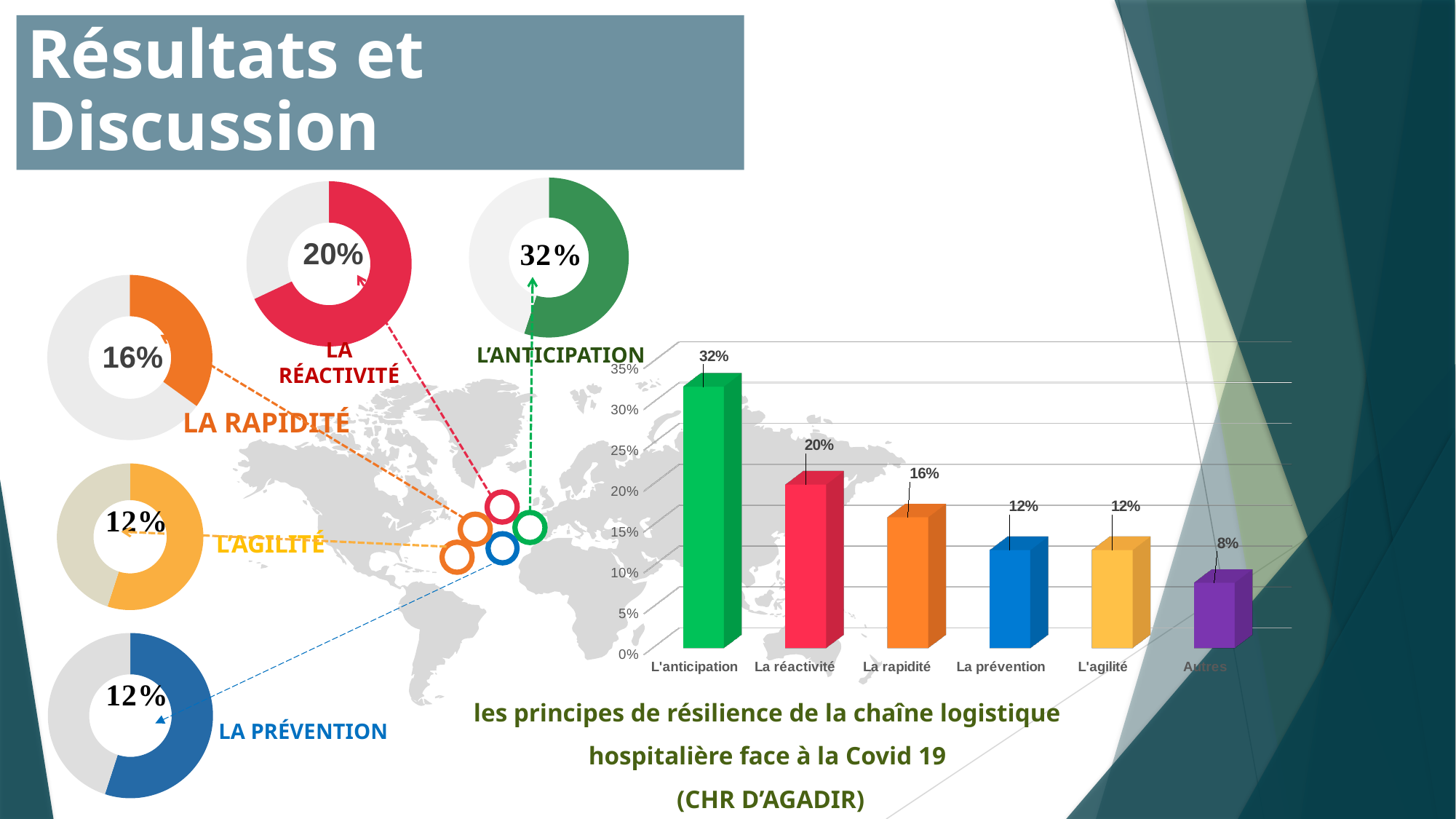
In the bar chart, what is the difference between the values for L'anticipation and La réactivité? 12% In the bar chart, which category has the lowest value? Autres In the bar chart, which is larger, the value for La rapidité or the value for La prévention? La rapidité In the bar chart, what is the value for Autres? 8% What value is shown in the green donut chart labelled L'ANTICIPATION? 32% In the bar chart, which category has the highest value? L'anticipation In the bar chart, what is the value for La rapidité? 16% What kind of chart shows the resilience principles (L'anticipation, La réactivité, etc.)? bar chart How many categories are shown in the bar chart? 6 In the bar chart, what is the value for L'anticipation? 32% Do the values in the bar chart rise or fall from left to right along the x axis? fall In the bar chart, what is the value for La réactivité? 20%